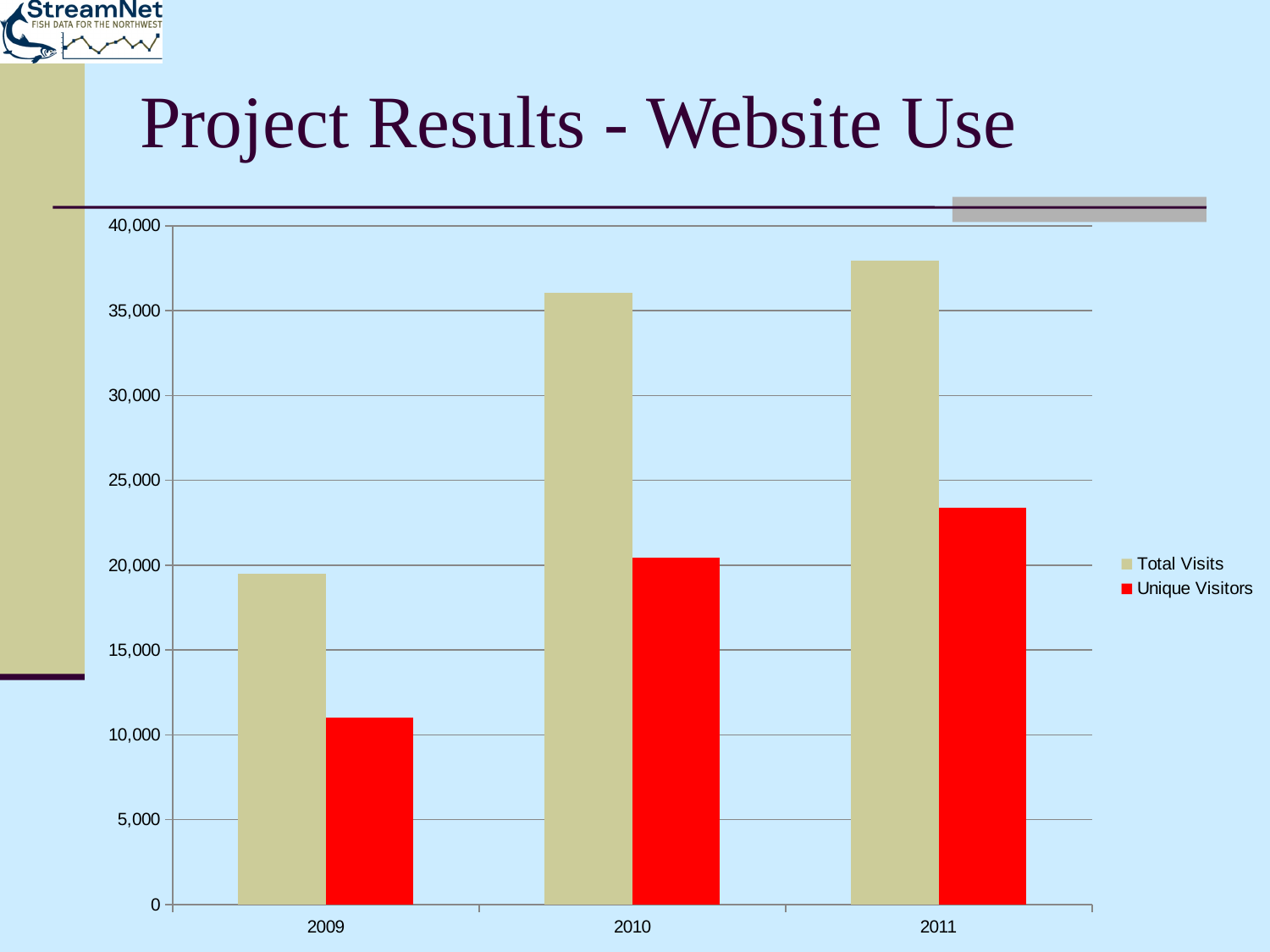
Is the value for Total Visits in 2009 greater or less than 20,000? less Which year has the highest Total Visits? 2011 Which year has the lowest Unique Visitors? 2009 What kind of chart is shown on the slide? bar chart Is the value for Total Visits in 2010 greater or less than 35,000? greater Is the value for Unique Visitors in 2011 greater or less than 20,000? greater Do Unique Visitors rise or fall from 2009 to 2011? rise Which is larger: Total Visits in 2009 or Unique Visitors in 2010? Unique Visitors in 2010 How many series does the legend list? 2 What colour are the Unique Visitors bars? red How many years are shown on the x axis? 3